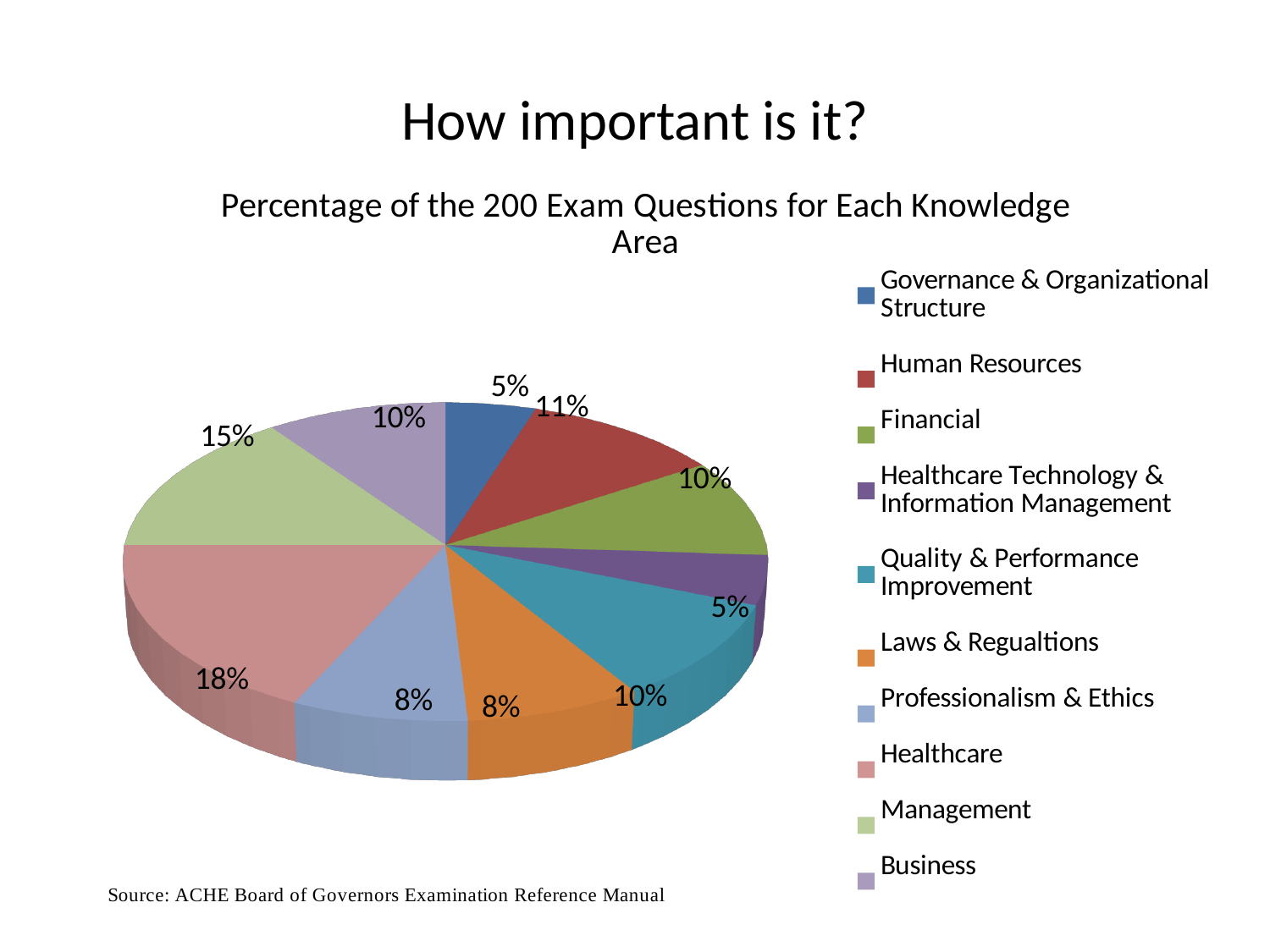
What is the source cited for the chart data? ACHE Board of Governors Examination Reference Manual What percentage of exam questions is for Governance & Organizational Structure? 5% How many knowledge areas (slices) does the pie chart show? 10 Which has a larger share of exam questions, Human Resources or Financial? Human Resources What is the difference between the Healthcare share and the Management share? 3% Which knowledge area has the largest share of exam questions? Healthcare What is the title of the chart? Percentage of the 200 Exam Questions for Each Knowledge Area What type of chart is shown on the slide? pie chart What percentage of exam questions is for Laws & Regualtions? 8% What percentage of exam questions is for Healthcare? 18% What percentage of exam questions is for Human Resources? 11% What percentage of exam questions is for Management? 15%